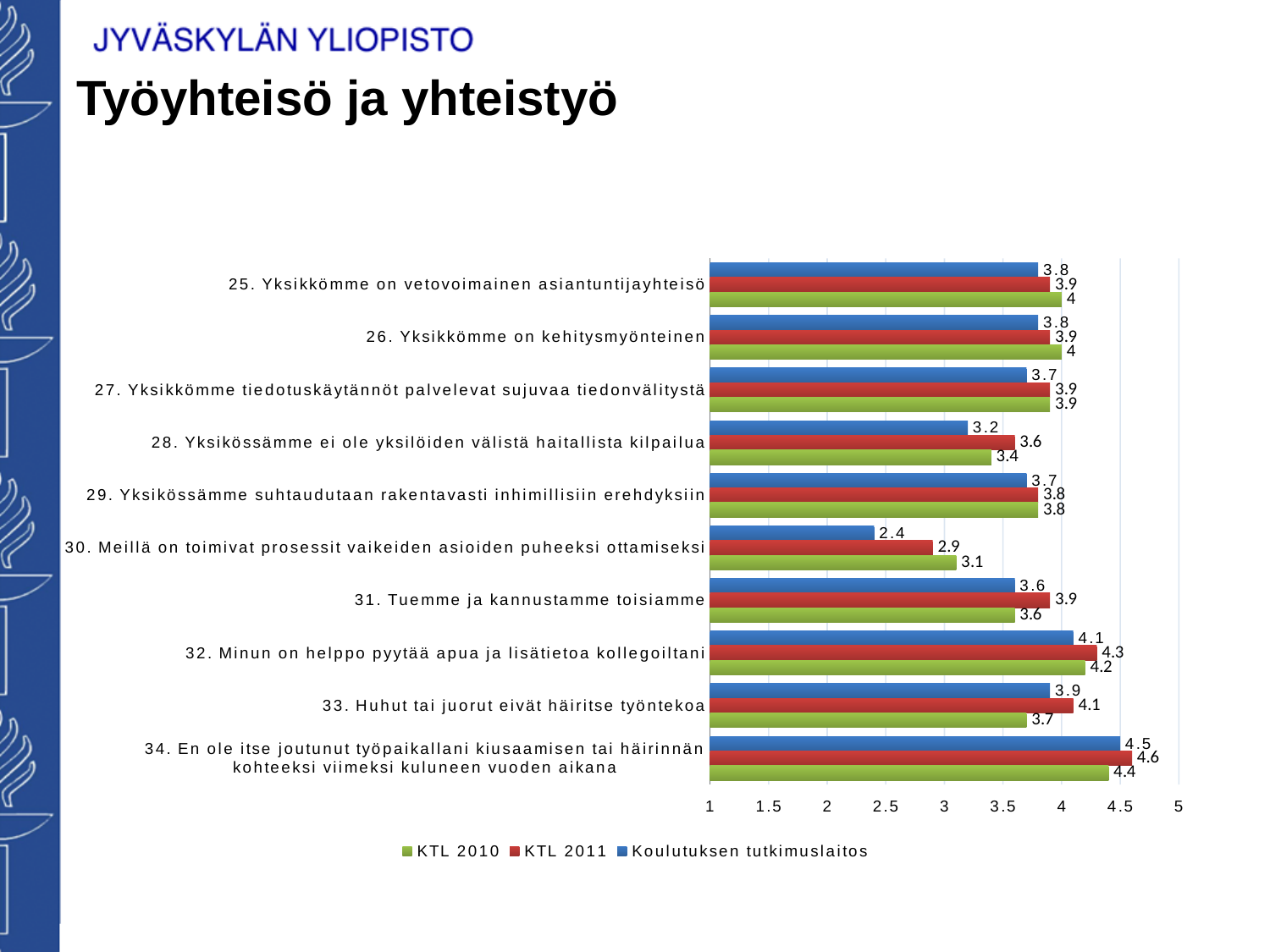
For item 33 (Huhut tai juorut eivät häiritse työntekoa), which series has the larger value: KTL 2010 or KTL 2011? KTL 2011 What is the KTL 2010 value for item 28 (Yksikössämme ei ole yksilöiden välistä haitallista kilpailua)? 3.4 How many series does the legend list? 3 What is the Koulutuksen tutkimuslaitos value for item 34 (En ole itse joutunut työpaikallani kiusaamisen tai häirinnän kohteeksi viimeksi kuluneen vuoden aikana)? 4.5 For item 32 (Minun on helppo pyytää apua ja lisätietoa kollegoiltani), how much higher is the KTL 2011 value than the Koulutuksen tutkimuslaitos value? 0.2 For item 30, what is the difference between the KTL 2010 value and the Koulutuksen tutkimuslaitos value? 0.7 Which colour represents the KTL 2011 series in the legend? Red Which item has the highest KTL 2010 value? 34. En ole itse joutunut työpaikallani kiusaamisen tai häirinnän kohteeksi viimeksi kuluneen vuoden aikana How many items (categories) are shown in the chart? 10 What kind of chart is shown on the slide? Bar chart What is the KTL 2011 value for item 30 (Meillä on toimivat prosessit vaikeiden asioiden puheeksi ottamiseksi)? 2.9 Which item has the lowest Koulutuksen tutkimuslaitos value? 30. Meillä on toimivat prosessit vaikeiden asioiden puheeksi ottamiseksi